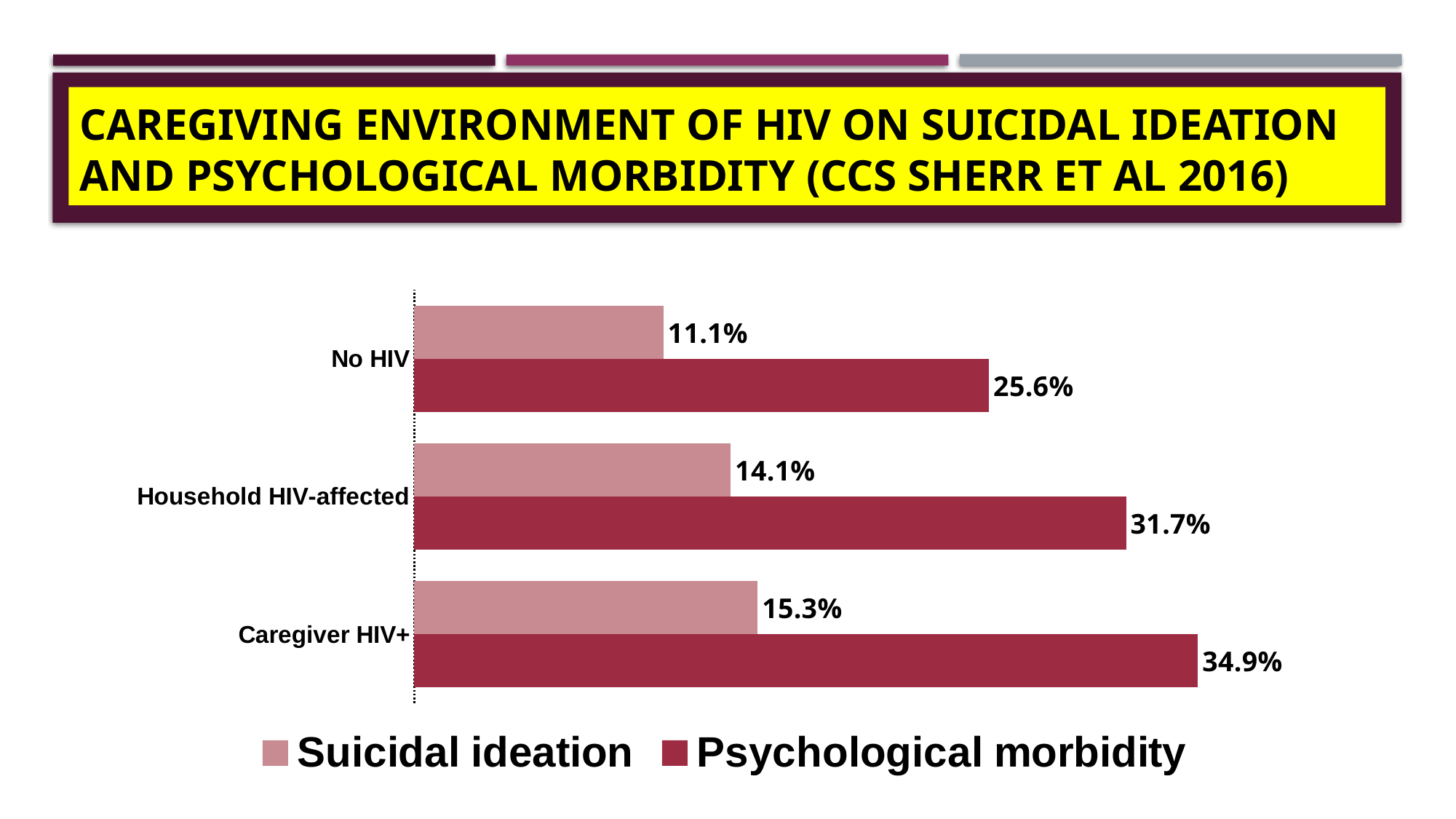
Which is larger: Suicidal ideation for Household HIV-affected or Suicidal ideation for No HIV? Household HIV-affected What kind of chart is shown on the slide? Bar chart What is the difference between the Psychological morbidity and Suicidal ideation values for No HIV? 14.5% What is the Suicidal ideation value for No HIV? 11.1% What is the Psychological morbidity value for Household HIV-affected? 31.7% What is the Suicidal ideation value for Caregiver HIV+? 15.3% Which category has the lowest Suicidal ideation value? No HIV How many categories are shown on the chart? 3 Which category has the highest Psychological morbidity value? Caregiver HIV+ What is the Psychological morbidity value for Caregiver HIV+? 34.9% How many series does the legend list? 2 What is the difference in Psychological morbidity between Caregiver HIV+ and Household HIV-affected? 3.2%